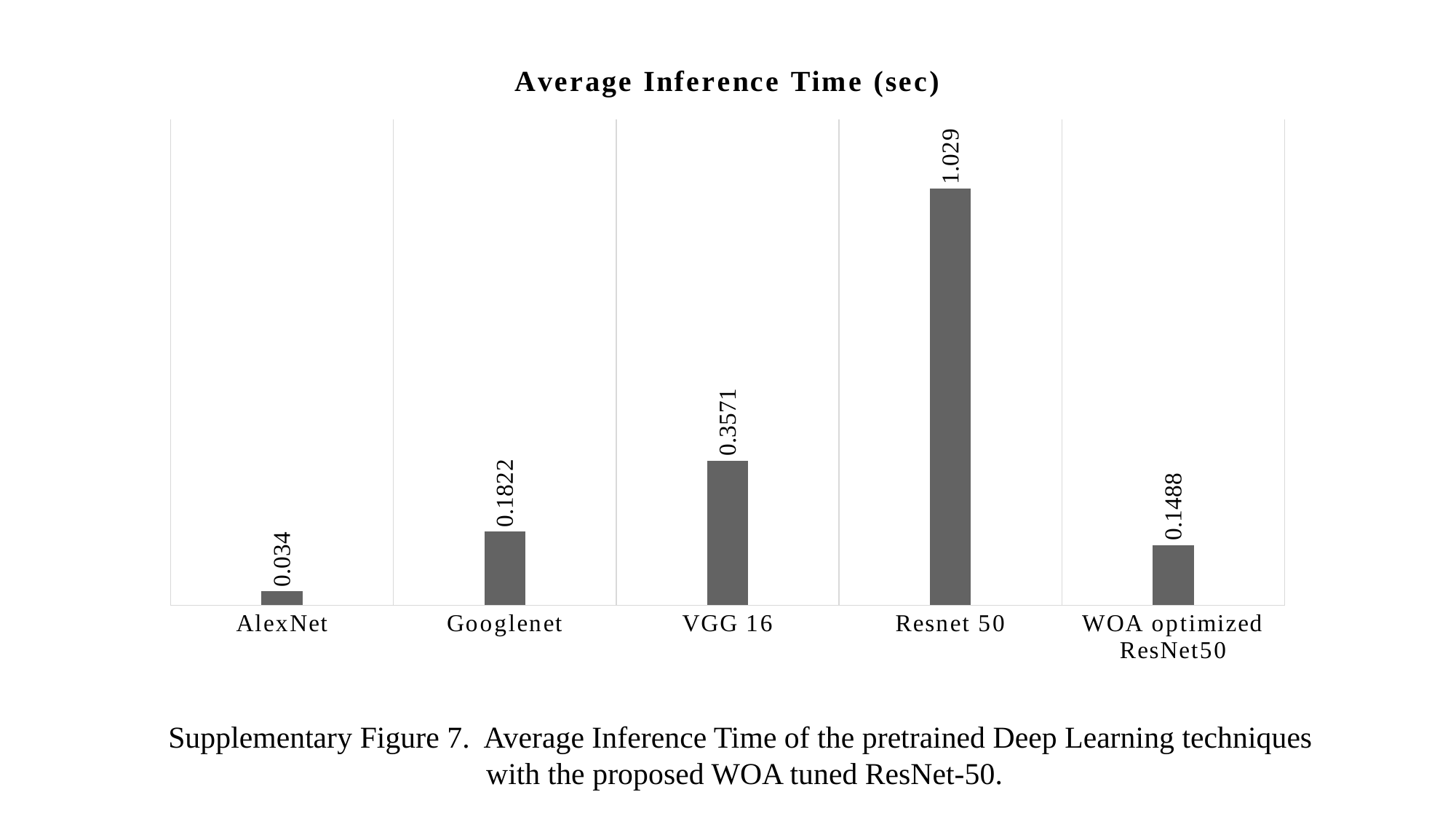
Which model has the lowest average inference time? AlexNet Which has a larger average inference time, Googlenet or WOA optimized ResNet50? Googlenet What is the average inference time for Googlenet? 0.1822 What is the average inference time for VGG 16? 0.3571 Which model has the highest average inference time? Resnet 50 What is the average inference time for Resnet 50? 1.029 What is the title of the chart? Average Inference Time (sec) How many models are shown in the chart? 5 What is the difference in average inference time between Resnet 50 and WOA optimized ResNet50? 0.8802 What is the average inference time for WOA optimized ResNet50? 0.1488 What is the average inference time for AlexNet? 0.034 What kind of chart is shown on the slide? Bar chart